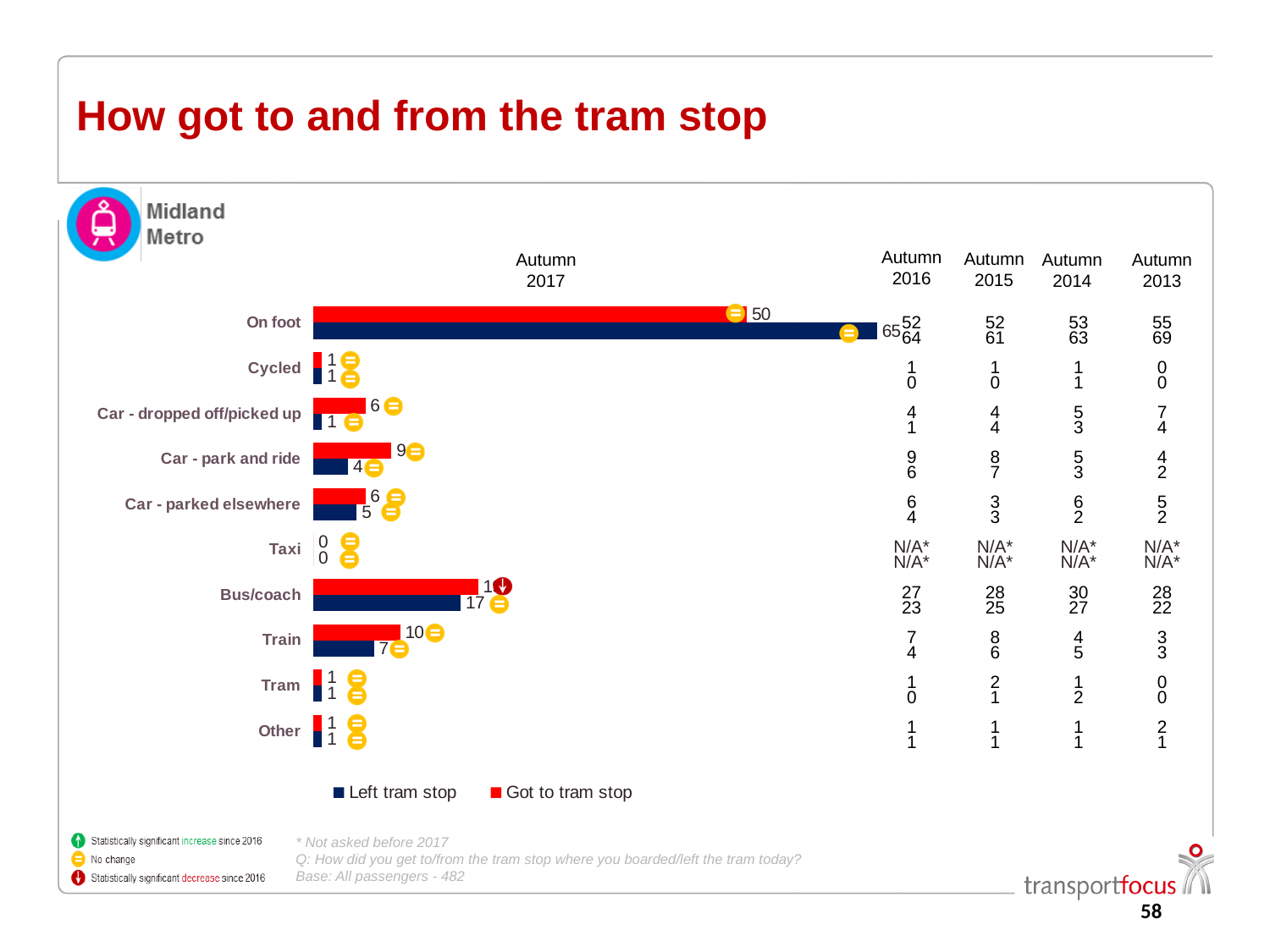
What colour represents the 'Got to tram stop' series in the chart? Red What is the Autumn 2017 value for 'Got to tram stop' for Train? 10 Which category has the highest 'Left tram stop' value in Autumn 2017? On foot What is the Autumn 2017 value for 'Left tram stop' for Car - park and ride? 4 What is the Autumn 2017 value for 'Left tram stop' for On foot? 65 What is the Autumn 2017 value for 'Got to tram stop' for On foot? 50 What is the difference between the 'Got to tram stop' and 'Left tram stop' values for Train in Autumn 2017? 3 How many series does the chart legend list? 2 What kind of chart is shown on the slide? Bar chart What is the difference between the 'Left tram stop' and 'Got to tram stop' values for On foot in Autumn 2017? 15 Which has the larger 'Got to tram stop' value in Autumn 2017: Car - park and ride or Car - parked elsewhere? Car - park and ride How many categories are plotted on the chart? 10